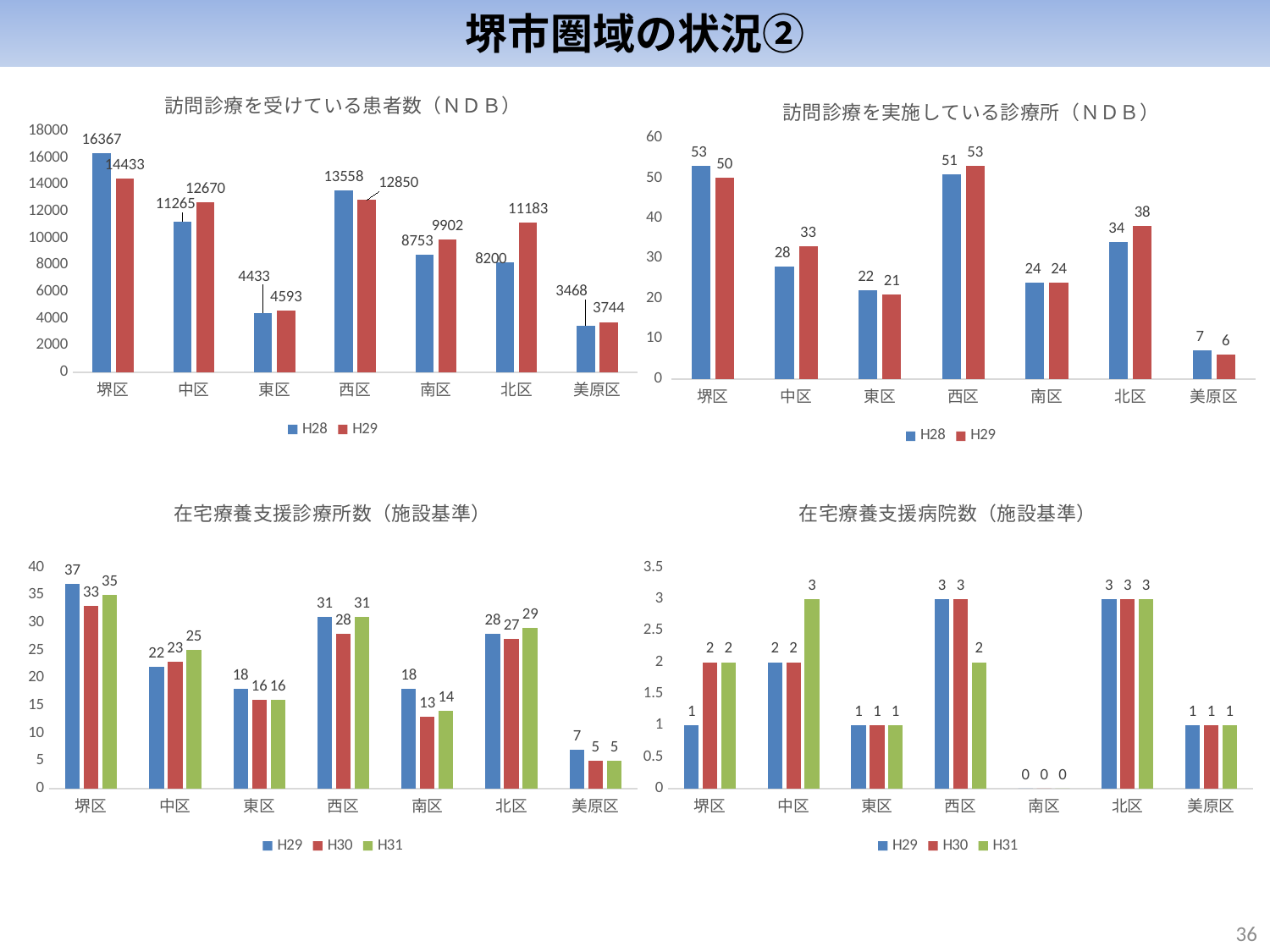
In the bottom-right chart titled 在宅療養支援病院数（施設基準）, what is the H31 value for 中区? 3 In the bottom-left chart titled 在宅療養支援診療所数（施設基準）, how many series does the legend list? 3 In the bottom-left chart titled 在宅療養支援診療所数（施設基準）, what is the H30 value for 南区? 13 In the top-right chart titled 訪問診療を実施している診療所（ＮＤＢ）, what is the H29 value for 中区? 33 In the top-right chart titled 訪問診療を実施している診療所（ＮＤＢ）, is the H28 value for 西区 larger or the H29 value for 西区? H29 What type of chart is the top-left chart titled 訪問診療を受けている患者数（ＮＤＢ）? Bar chart In the top-left chart titled 訪問診療を受けている患者数（ＮＤＢ）, which category has the highest H28 value? 堺区 In the top-right chart titled 訪問診療を実施している診療所（ＮＤＢ）, which category has the lowest H29 value? 美原区 In the top-left chart titled 訪問診療を受けている患者数（ＮＤＢ）, what is the H29 value for 北区? 11183 In the bottom-left chart titled 在宅療養支援診療所数（施設基準）, what is the total of the H29, H30 and H31 values for 美原区? 17 In the bottom-right chart titled 在宅療養支援病院数（施設基準）, how many categories are shown on the x axis? 7 In the top-left chart titled 訪問診療を受けている患者数（ＮＤＢ）, what is the difference between the H28 and H29 values for 堺区? 1934